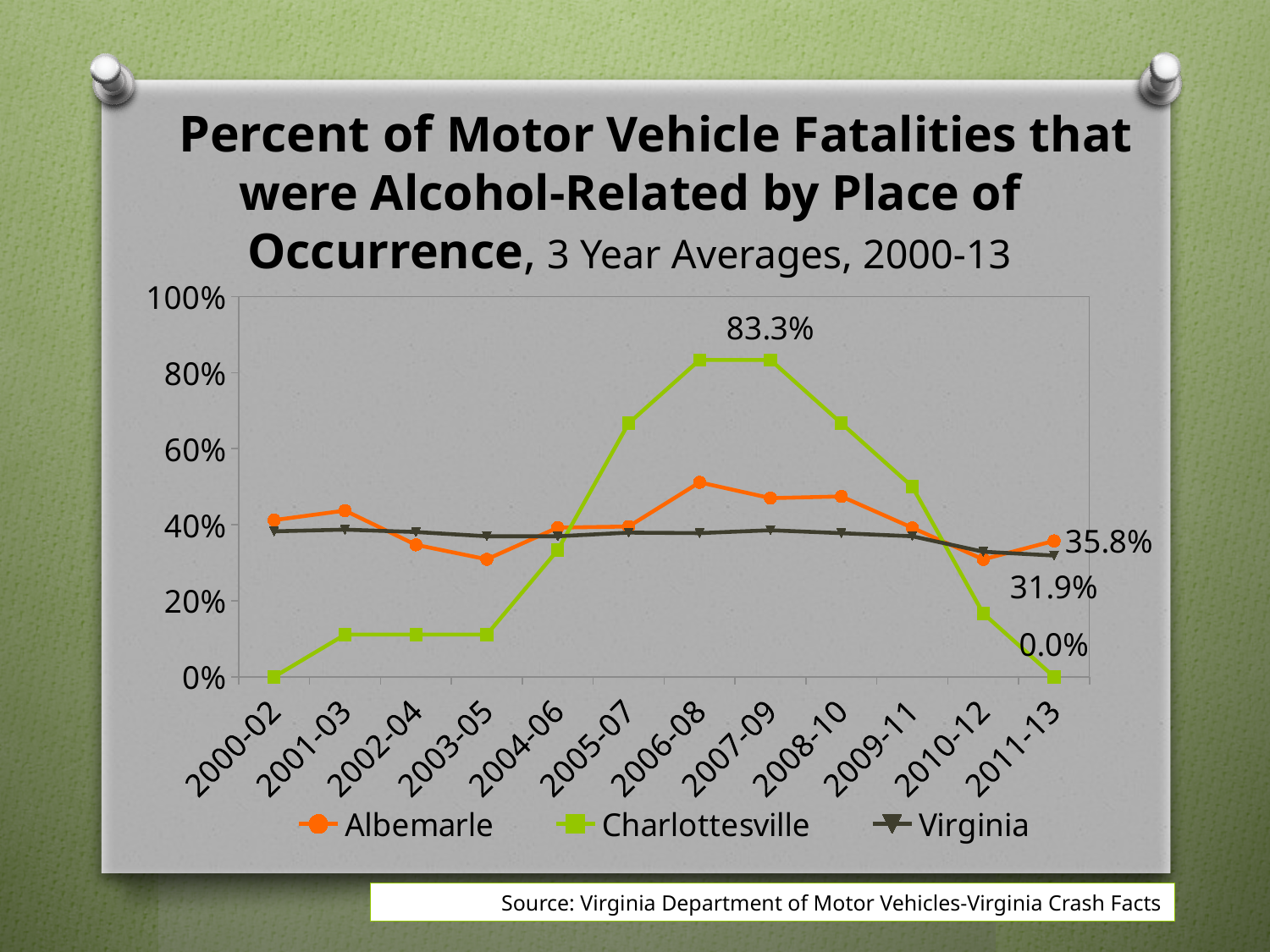
How many series does the legend list? 3 What is the value for Charlottesville in 2011-13? 0.0% What is the value for Virginia in 2011-13? 31.9% Does the Charlottesville line rise or fall from 2007-09 to 2011-13? fall In 2011-13, which is larger, the Albemarle value or the Virginia value? Albemarle What is the labelled value for Charlottesville in 2006-08? 83.3% In 2011-13, how many percentage points higher is Albemarle than Virginia? 3.9 What is the value for Albemarle in 2011-13? 35.8% Which series has the highest value in 2006-08? Charlottesville How many time periods are shown on the x axis? 12 Is the value for Albemarle in 2006-08 greater or less than 40%? greater What kind of chart is shown on the slide? line chart